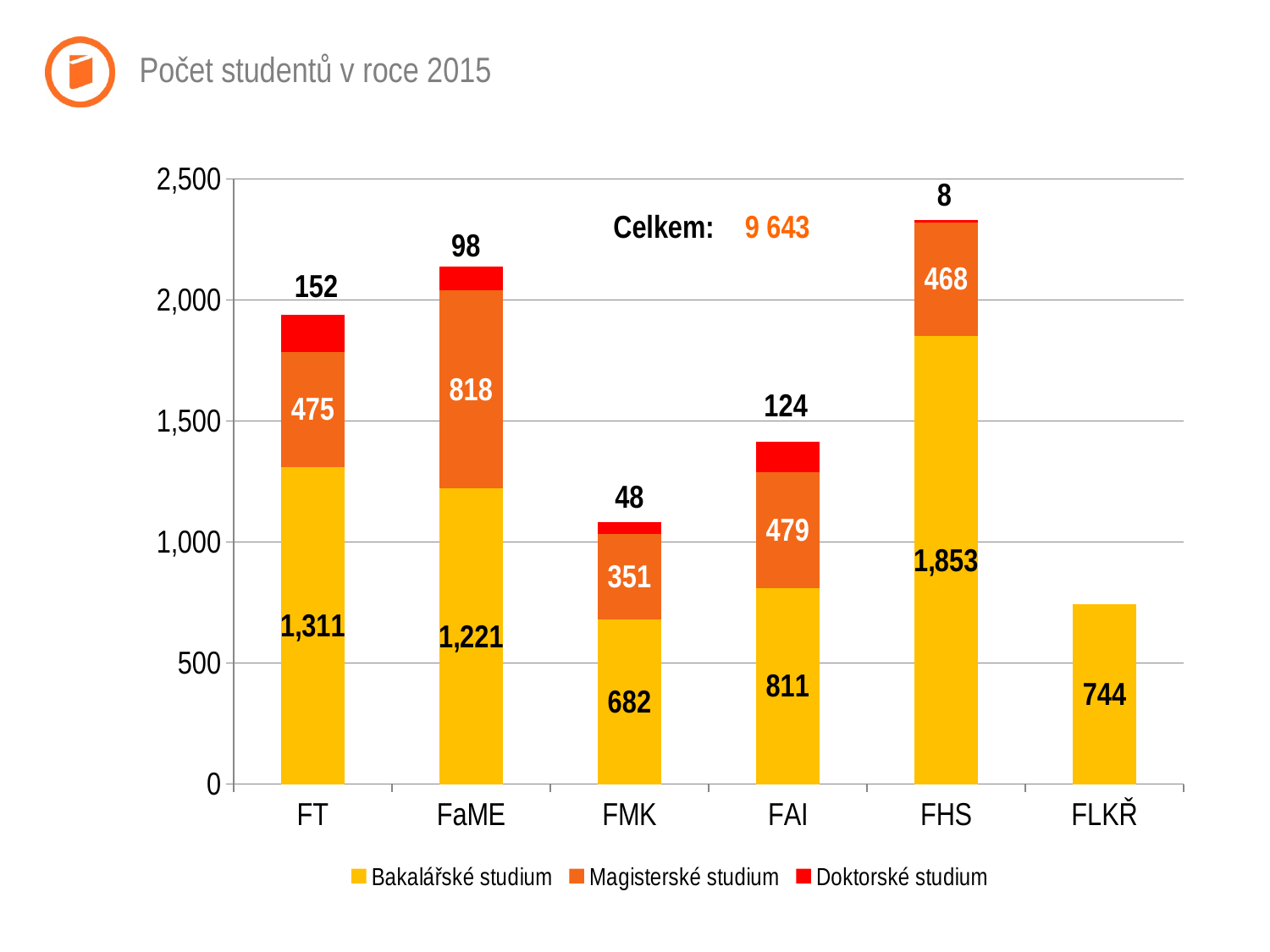
What is the Bakalářské studium value for FHS? 1,853 What is the Magisterské studium value for FaME? 818 Which category has the highest Bakalářské studium value? FHS What is the difference between the Bakalářské studium values for FT and FaME? 90 What kind of chart is shown on the slide? stacked bar chart Which is larger, the Magisterské studium value for FT or for FAI? FAI How many categories are shown on the x axis? 6 How many series does the legend list? 3 Is the total stacked value for FMK greater or less than 1,000? greater What is the total of the stacked bar for FHS? 2,329 What is the Doktorské studium value for FAI? 124